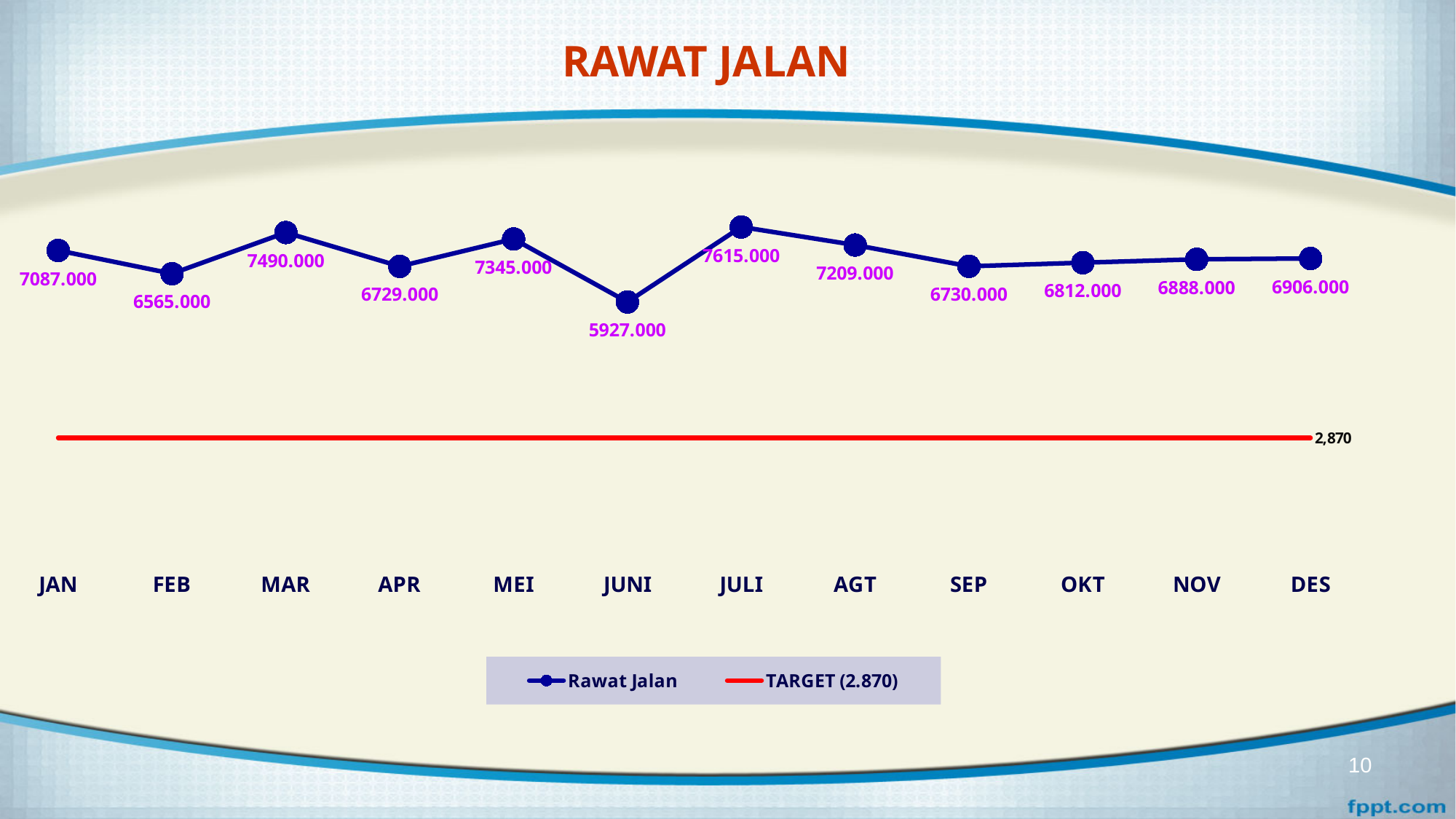
What kind of chart is shown on the slide? line chart What value is labelled on the red TARGET line? 2,870 Which month has the highest Rawat Jalan value? JULI How many series does the legend list? 2 What is the Rawat Jalan value for DES? 6906.000 Which is larger, the Rawat Jalan value for SEP or for OKT? OKT What is the Rawat Jalan value for JUNI? 5927.000 What is the difference between the Rawat Jalan values for MAR and FEB? 925.000 How many months are plotted on the x axis? 12 From SEP to DES, do the Rawat Jalan values rise or fall? rise Which month has the lowest Rawat Jalan value? JUNI What is the Rawat Jalan value for MAR? 7490.000